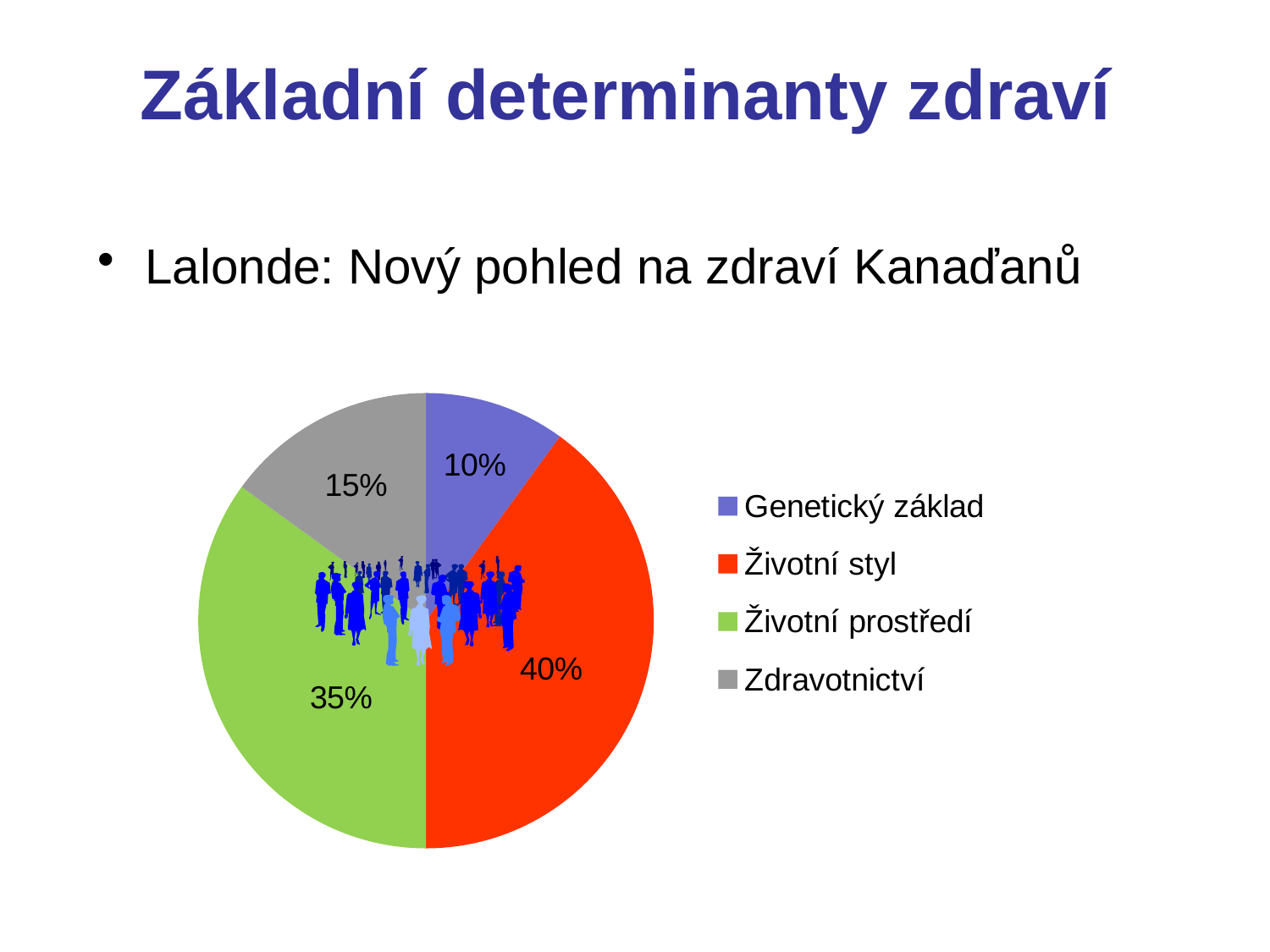
What share of the pie does Zdravotnictví have? 15% What share of the pie does Životní styl have? 40% What is the difference in percentage points between Životní styl and Životní prostředí? 5 What is the difference in percentage points between Zdravotnictví and Genetický základ? 5 What type of chart is shown on the slide? pie chart Which category has the largest slice of the pie? Životní styl What share of the pie does Genetický základ have? 10% What share of the pie does Životní prostředí have? 35% Which is larger, the slice for Zdravotnictví or the slice for Genetický základ? Zdravotnictví What colour is the slice for Životní prostředí? green Which category has the smallest slice of the pie? Genetický základ How many categories does the pie chart have? 4